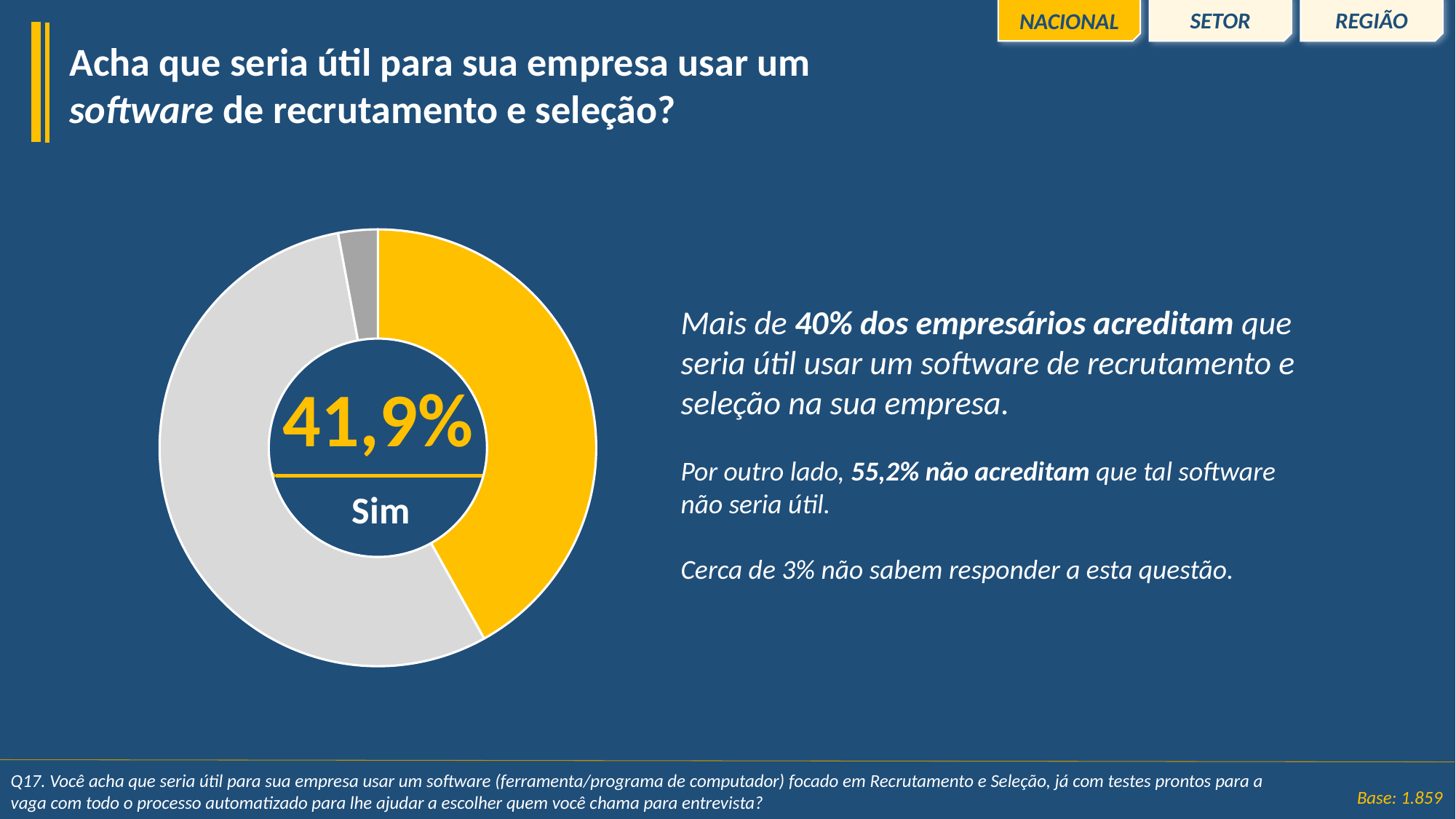
Which is larger in the donut chart: the yellow slice or the light gray slice? The light gray slice Which colour slice of the donut chart is the largest? Light gray What label appears in the centre of the donut chart below the percentage? Sim How many slices does the donut chart have? 3 What percentage is shown for "Sim" in the centre of the donut chart? 41,9% What is the base (number of respondents) shown on the slide? 1.859 What colour is the "Sim" slice of the donut chart? Yellow Is the share of the yellow "Sim" slice greater or less than 50%? less Which is larger in the donut chart: the yellow slice or the dark gray slice? The yellow slice What kind of chart is shown on the slide? Pie chart (donut) According to the text beside the chart, what percentage of respondents do not believe the software would be useful? 55,2% Which colour slice of the donut chart is the smallest? Dark gray